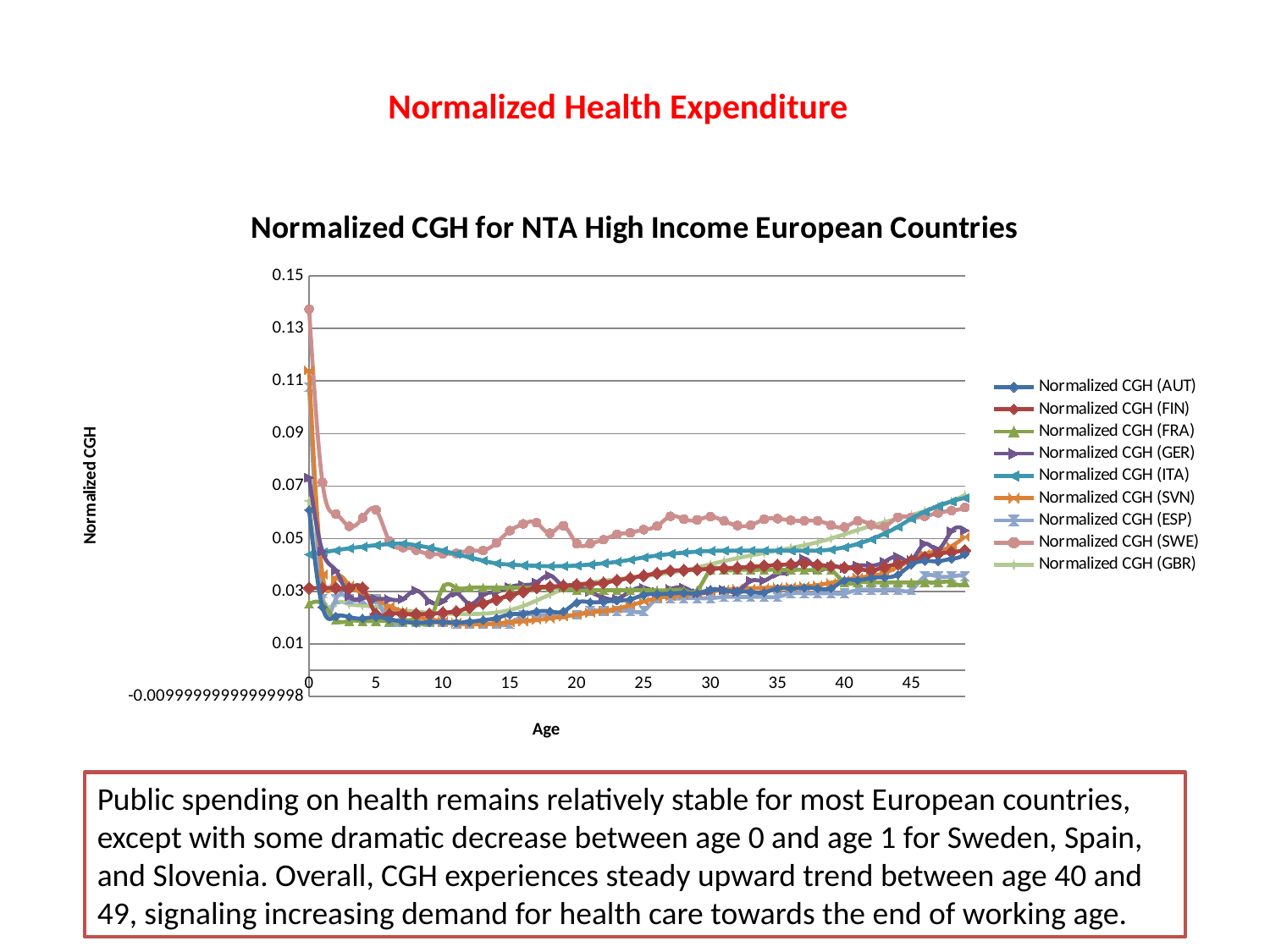
What kind of chart is shown on the slide? line chart Does the Normalized CGH (ITA) series rise or fall between age 40 and age 49? rise Which series has the highest value at age 30? Normalized CGH (SWE) Does the Normalized CGH (SWE) series rise or fall between age 0 and age 5? fall Which series has the highest value at age 0? Normalized CGH (SWE) How many series does the legend list? 9 What is the label of the x axis? Age Is the value for Normalized CGH (ITA) at age 20 greater or less than 0.05? less What is the title of the chart? Normalized CGH for NTA High Income European Countries Is the value for Normalized CGH (SWE) at age 30 greater or less than 0.05? greater At age 10, which is larger: Normalized CGH (ITA) or Normalized CGH (AUT)? Normalized CGH (ITA) Is the value for Normalized CGH (SWE) at age 0 greater or less than 0.11? greater